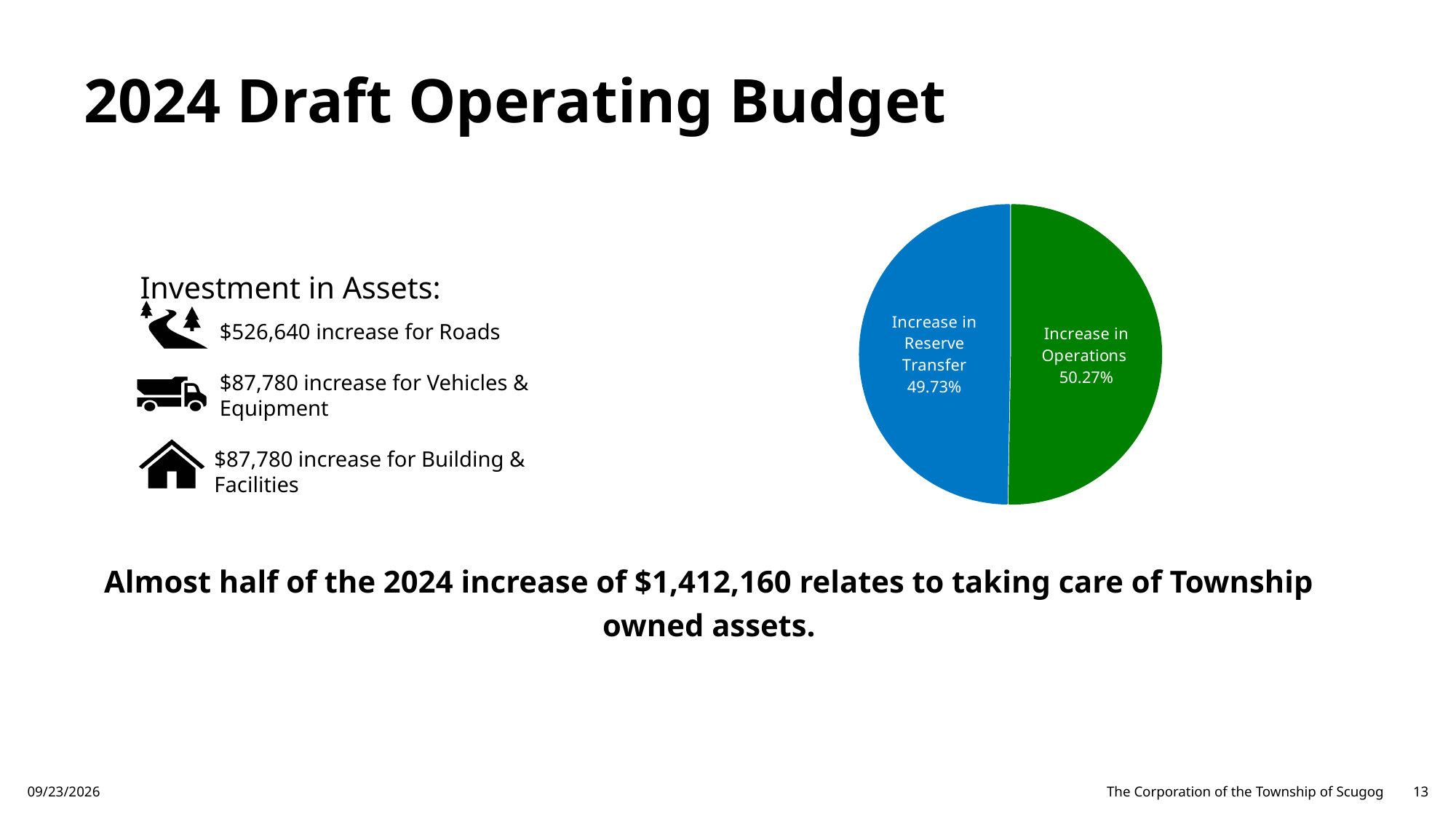
Which slice of the pie chart is the smallest? Increase in Reserve Transfer Is the share for Increase in Operations greater or less than 50%? greater What share of the pie is labelled Increase in Reserve Transfer? 49.73% Which is larger, the share for Increase in Operations or the share for Increase in Reserve Transfer? Increase in Operations How many slices does the pie chart have? 2 Which slice of the pie chart is the largest? Increase in Operations What kind of chart is shown on the slide? pie chart What colour is the Increase in Operations slice of the pie chart? green Is the share for Increase in Reserve Transfer greater or less than 50%? less What share of the pie is labelled Increase in Operations? 50.27% What is the difference in percentage points between the Increase in Operations slice and the Increase in Reserve Transfer slice? 0.54% What colour is the Increase in Reserve Transfer slice of the pie chart? blue